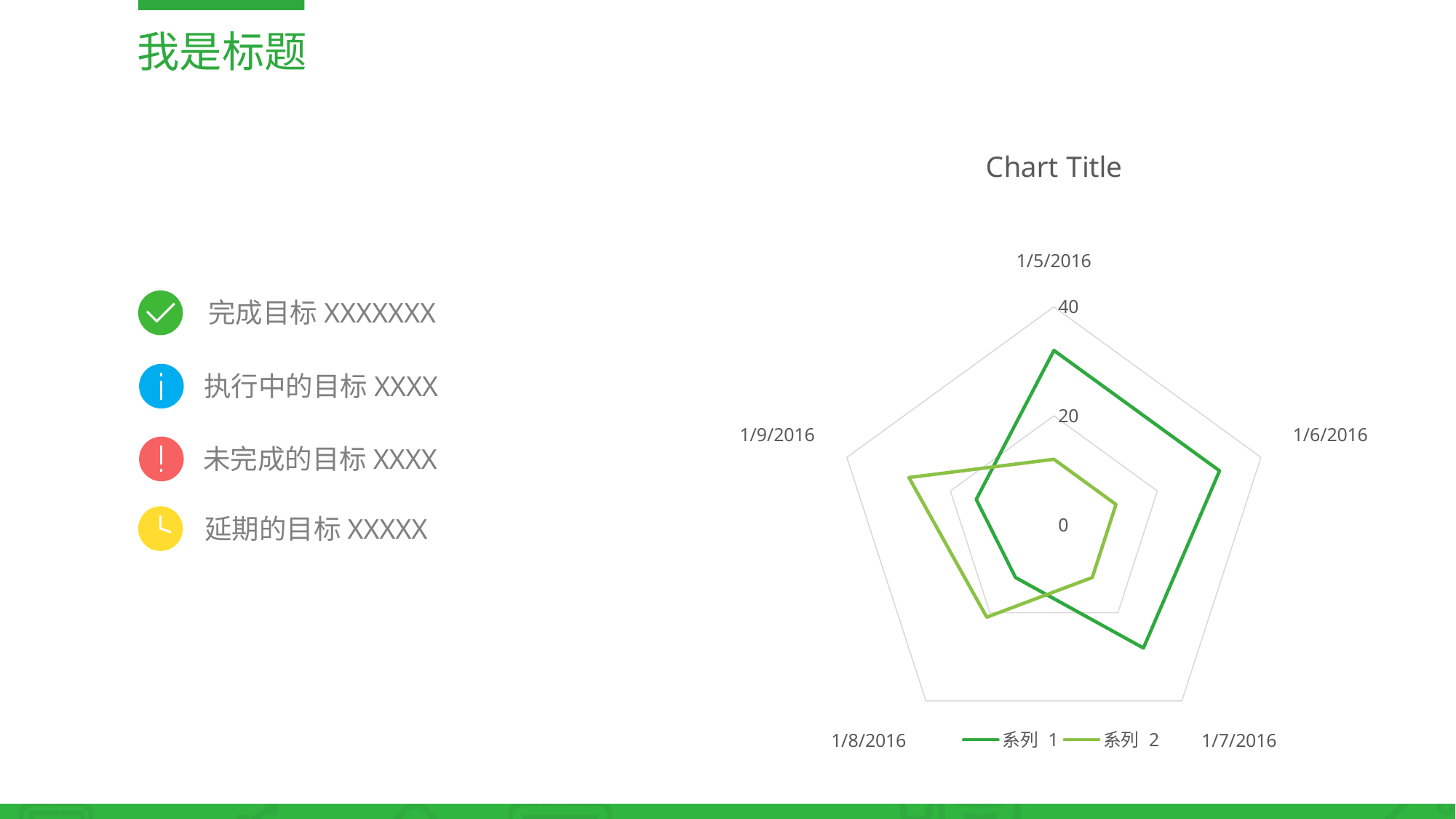
At 1/5/2016, which series has the larger value, 系列 1 or 系列 2? 系列 1 What is the title of the chart? Chart Title For which date does 系列 2 have its highest value? 1/9/2016 How many categories (dates) does the radar chart have? 5 How many series does the chart legend list? 2 At 1/9/2016, which series has the larger value, 系列 1 or 系列 2? 系列 2 Is the value of 系列 1 for 1/5/2016 greater or less than 20? greater Is the value of 系列 2 for 1/9/2016 greater or less than 20? greater What are the two series names shown in the legend? 系列 1 and 系列 2 Is the value of 系列 1 for 1/8/2016 greater or less than 20? less What kind of chart is shown on the slide? Radar chart